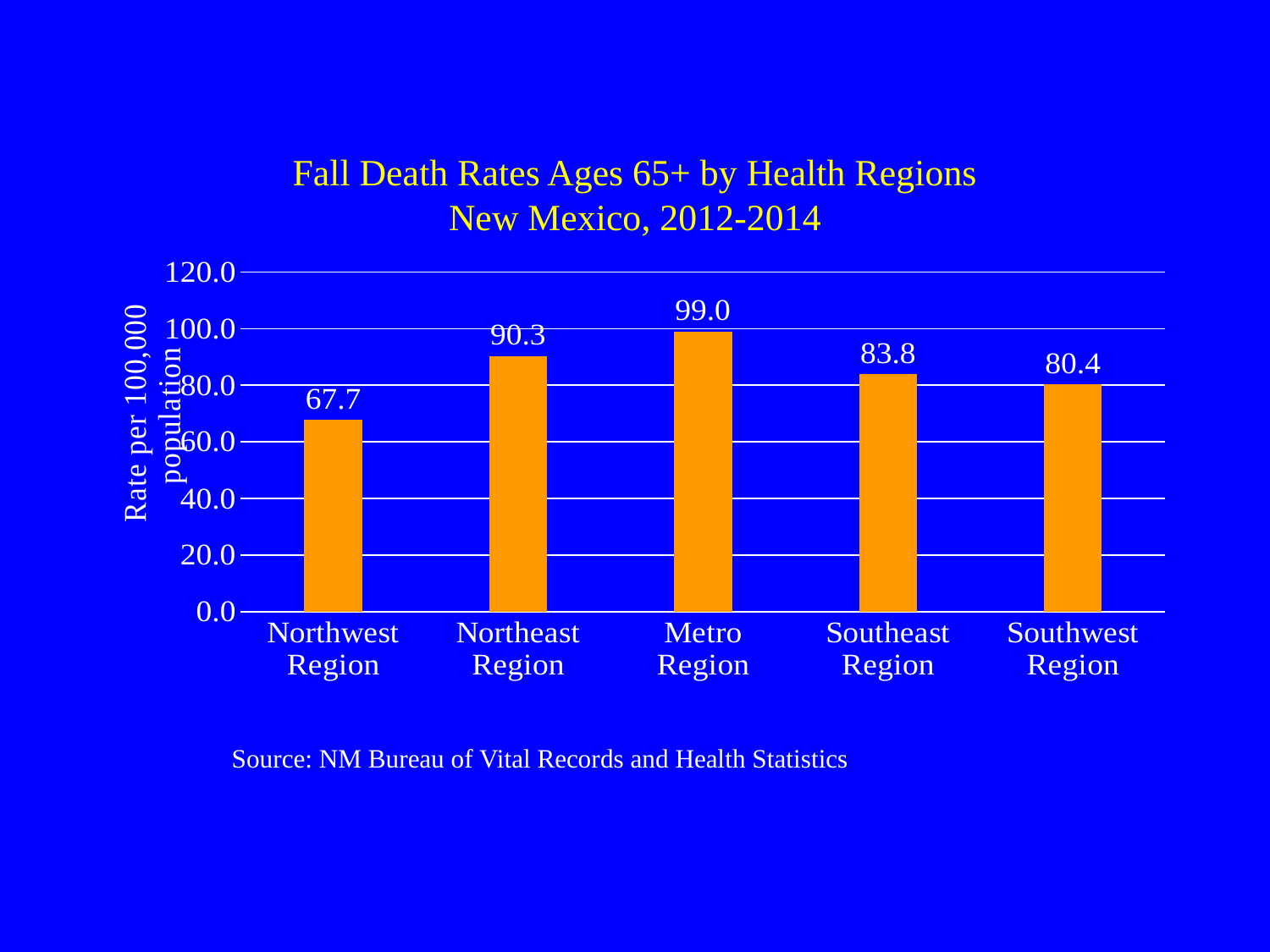
What kind of chart is shown on the slide? Bar chart How many regions are shown in the chart? 5 What is the difference between the fall death rates of the Northeast Region and the Southwest Region? 9.9 Which region has the highest fall death rate? Metro Region Which region has the lowest fall death rate? Northwest Region What is the fall death rate for the Metro Region? 99.0 What is the label of the y axis? Rate per 100,000 population Which has a higher fall death rate, the Southeast Region or the Southwest Region? Southeast Region What is the difference between the fall death rates of the Metro Region and the Northwest Region? 31.3 Is the value for the Northeast Region greater or less than 80.0? greater What is the fall death rate for the Southeast Region? 83.8 What is the fall death rate for the Northwest Region? 67.7